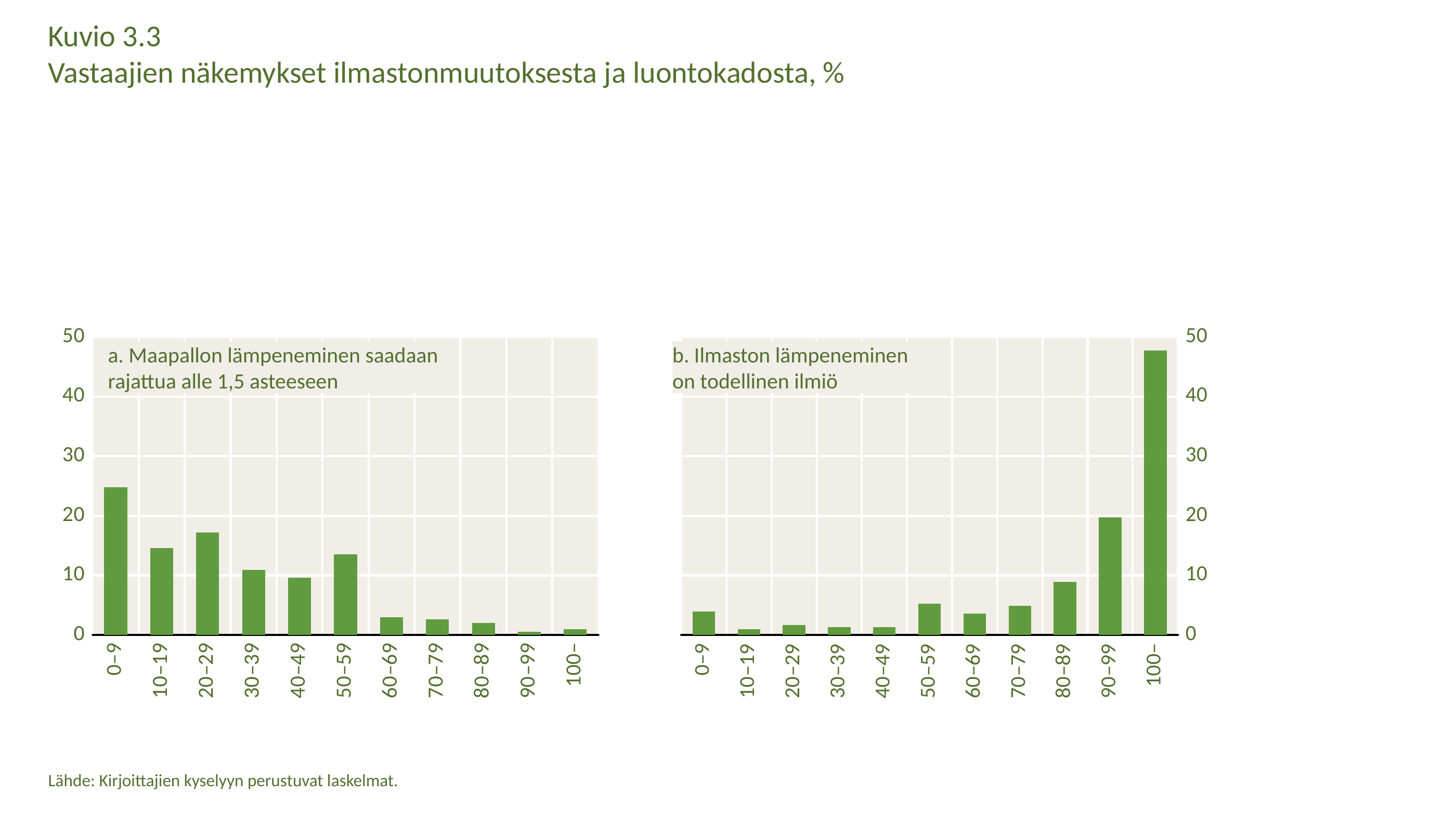
In chart b (Ilmaston lämpeneminen on todellinen ilmiö), is the value for 0–9 greater or less than 10? less In chart a (Maapallon lämpeneminen saadaan rajattua alle 1,5 asteeseen), which category has the highest value? 0–9 In chart a (Maapallon lämpeneminen saadaan rajattua alle 1,5 asteeseen), is the value for 20–29 greater or less than 20? less What is the title of the slide? Kuvio 3.3 Vastaajien näkemykset ilmastonmuutoksesta ja luontokadosta, % In chart b (Ilmaston lämpeneminen on todellinen ilmiö), is the value for 100– greater or less than 40? greater In chart b (Ilmaston lämpeneminen on todellinen ilmiö), which category has the highest value? 100– How many categories are shown on the x axis of chart a (Maapallon lämpeneminen saadaan rajattua alle 1,5 asteeseen)? 11 In chart b (Ilmaston lämpeneminen on todellinen ilmiö), do the values generally rise or fall from 50–59 to 100–? Rise In chart b (Ilmaston lämpeneminen on todellinen ilmiö), which is larger, the value for 80–89 or the value for 90–99? 90–99 In chart a (Maapallon lämpeneminen saadaan rajattua alle 1,5 asteeseen), which is larger, the value for 10–19 or the value for 20–29? 20–29 What kind of chart is chart b (Ilmaston lämpeneminen on todellinen ilmiö)? Bar chart